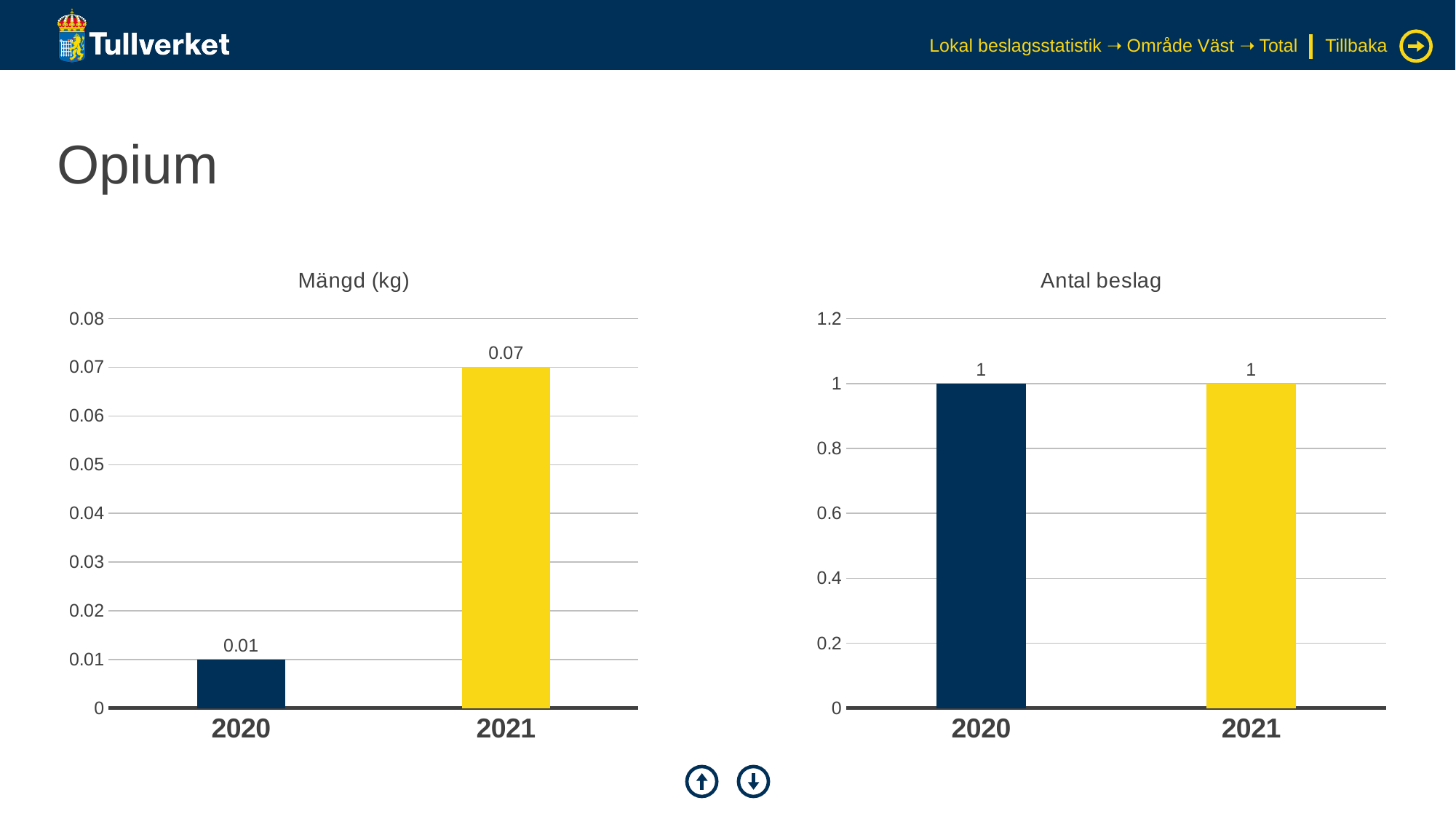
What kind of chart is the 'Mängd (kg)' chart? bar chart In the 'Mängd (kg)' chart, which year has the lowest value? 2020 What is the title of the chart on the right side of the slide? Antal beslag In the 'Mängd (kg)' chart, what is the value for 2021? 0.07 In the 'Mängd (kg)' chart, which year has the highest value? 2021 In the 'Antal beslag' chart, what is the value for 2020? 1 In the 'Mängd (kg)' chart, is the value for 2021 greater or less than 0.05? greater In the 'Antal beslag' chart, what is the difference between the values for 2020 and 2021? 0 In the 'Mängd (kg)' chart, do the values rise or fall from 2020 to 2021? rise How many years are shown in the 'Antal beslag' chart? 2 In the 'Mängd (kg)' chart, what is the difference between the values for 2021 and 2020? 0.06 In the 'Mängd (kg)' chart, what is the value for 2020? 0.01